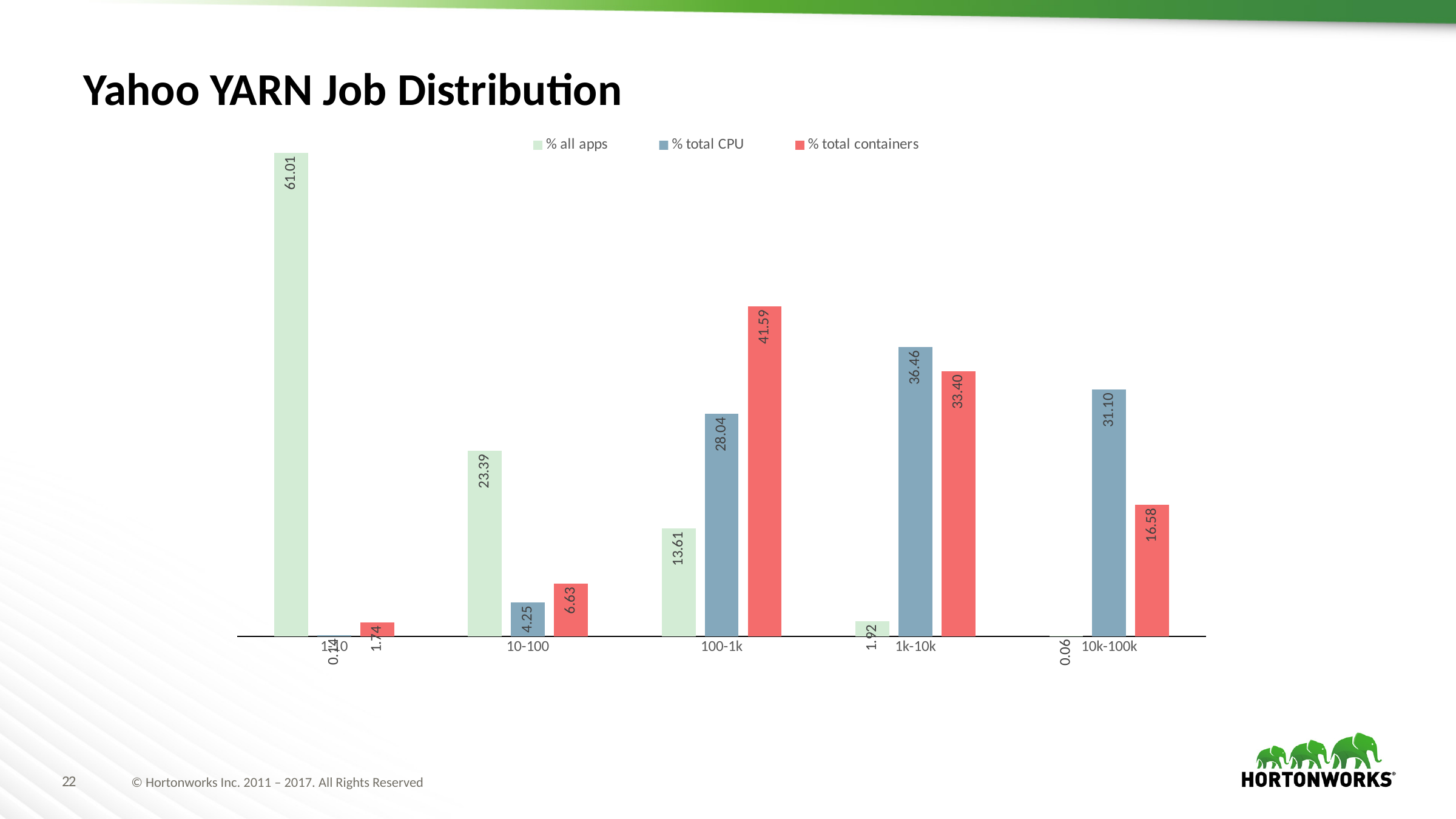
What is the difference between the % total containers and % total CPU values for the 100-1k category? 13.55 What is the % total containers value for the 100-1k category? 41.59 Do the % all apps values rise or fall moving from left to right along the x axis? fall Which category has the highest % all apps value? 1-10 What type of chart is shown on the slide? bar chart What is the % all apps value for the 10-100 category? 23.39 Which category has the lowest % total containers value? 1-10 How many series does the legend list? 3 How many categories are shown on the x axis? 5 For the 10k-100k category, which is larger: % total CPU or % total containers? % total CPU What is the % total CPU value for the 10k-100k category? 31.10 Which category has the highest % total CPU value? 1k-10k